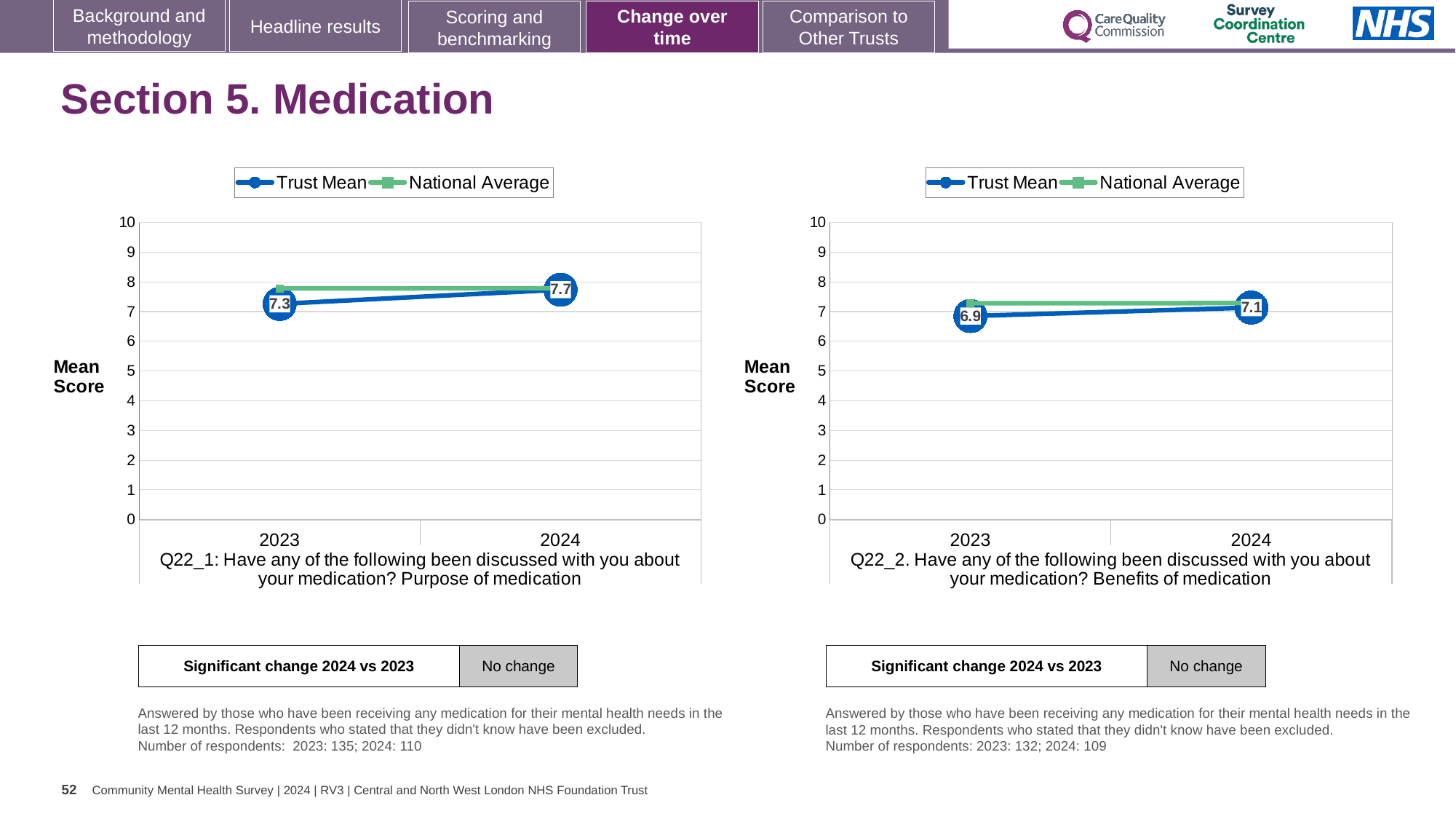
In the left chart (Q22_1: Purpose of medication), what is the Trust Mean for 2024? 7.7 In the left chart (Q22_1: Purpose of medication), what is the Trust Mean for 2023? 7.3 In the left chart (Q22_1), does the Trust Mean rise or fall from 2023 to 2024? rise In the right chart (Q22_2), by how much did the Trust Mean change from 2023 to 2024? 0.2 In the right chart (Q22_2: Benefits of medication), what is the Trust Mean for 2024? 7.1 In the right chart (Q22_2: Benefits of medication), what is the Trust Mean for 2023? 6.9 What kind of chart is the left chart (Q22_1)? line chart In the right chart (Q22_2), which year has the higher Trust Mean, 2023 or 2024? 2024 How many series does the legend of the right chart (Q22_2) list? 2 In the left chart (Q22_1), by how much did the Trust Mean change from 2023 to 2024? 0.4 In the right chart (Q22_2), is the National Average for 2023 greater or less than 5? greater How many years are shown on the x axis of the left chart (Q22_1)? 2